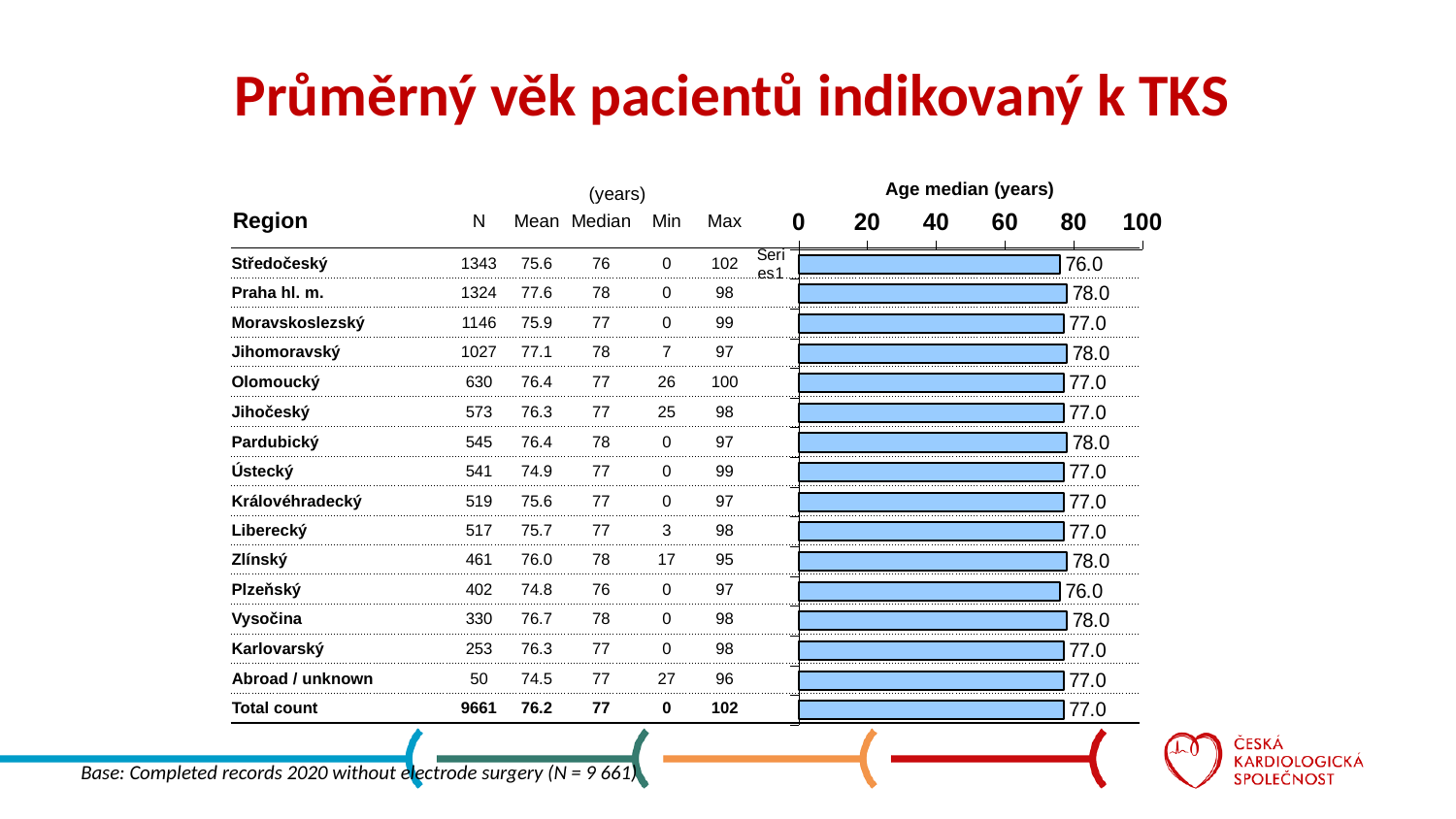
In the bar chart, what is the difference in age median between Zlínský and Plzeňský? 2.0 What is the highest tick value shown on the bar chart's horizontal axis? 100 What is the age median (years) shown for Plzeňský in the bar chart? 76.0 What is the age median (years) shown for the Total count bar in the chart? 77.0 In the bar chart, which has a higher age median: Praha hl. m. or Středočeský? Praha hl. m. What is the age median (years) shown for Vysočina in the bar chart? 78.0 What is the age median (years) shown for Olomoucký in the bar chart? 77.0 What is the title of the bar chart on the slide? Age median (years) How many bars are plotted in the age median chart? 16 What is the age median (years) shown for Praha hl. m. in the bar chart? 78.0 What kind of chart is used to show the age median (years)? bar chart Is the age median value for Karlovarský in the bar chart greater or less than 60? greater